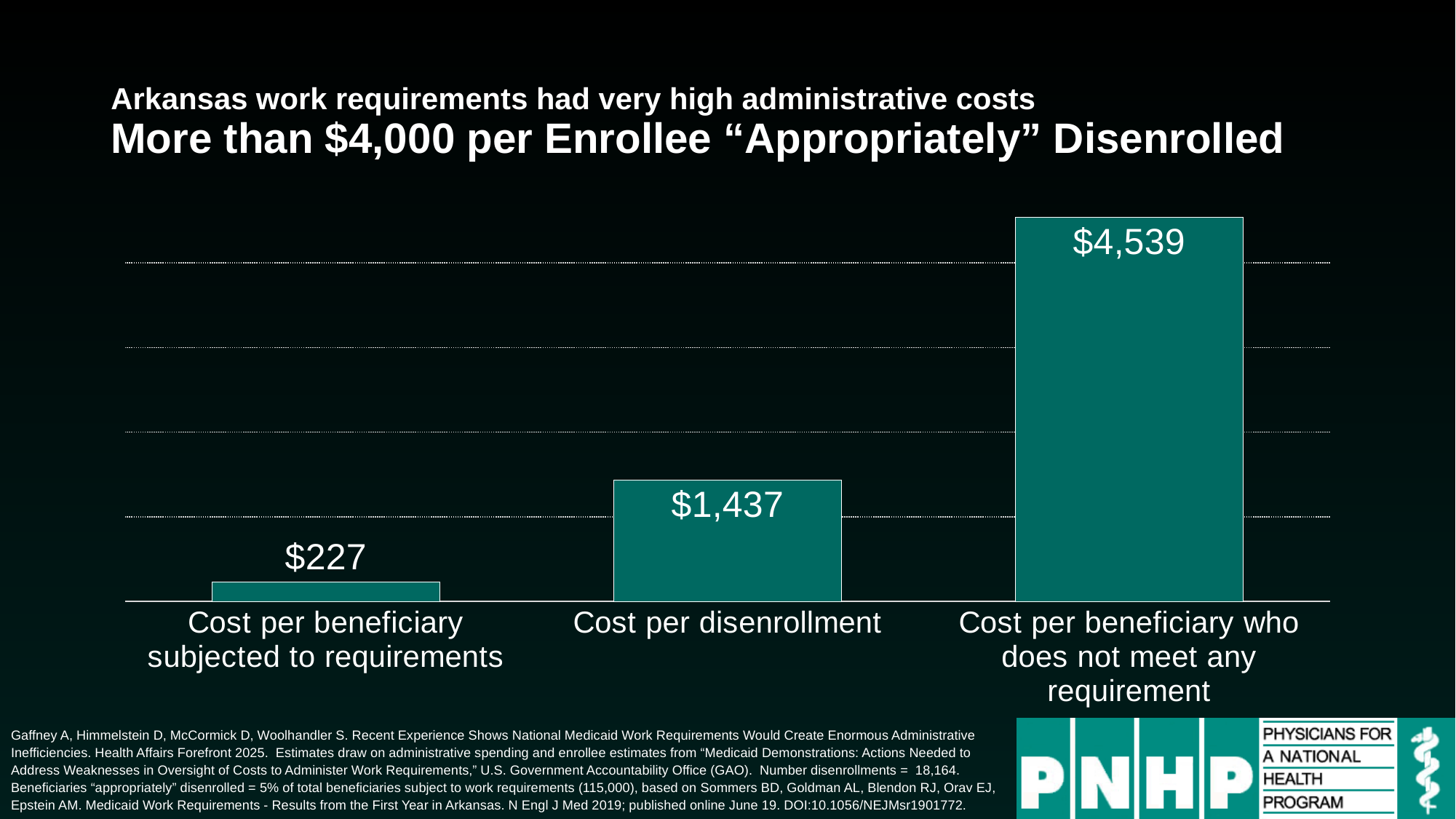
What is the cost per disenrollment? $1,437 Which is larger: the cost per disenrollment or the cost per beneficiary subjected to requirements? Cost per disenrollment Which category has the highest value? Cost per beneficiary who does not meet any requirement Do the values rise or fall from left to right across the categories? Rise What kind of chart is shown on the slide? Bar chart How many categories are shown in the chart? 3 What is the difference between the cost per disenrollment and the cost per beneficiary subjected to requirements? $1,210 Which category has the lowest value? Cost per beneficiary subjected to requirements What is the cost per beneficiary who does not meet any requirement? $4,539 What is the main title of the slide above the chart? More than $4,000 per Enrollee "Appropriately" Disenrolled What is the difference between the cost per beneficiary who does not meet any requirement and the cost per disenrollment? $3,102 What is the cost per beneficiary subjected to requirements? $227